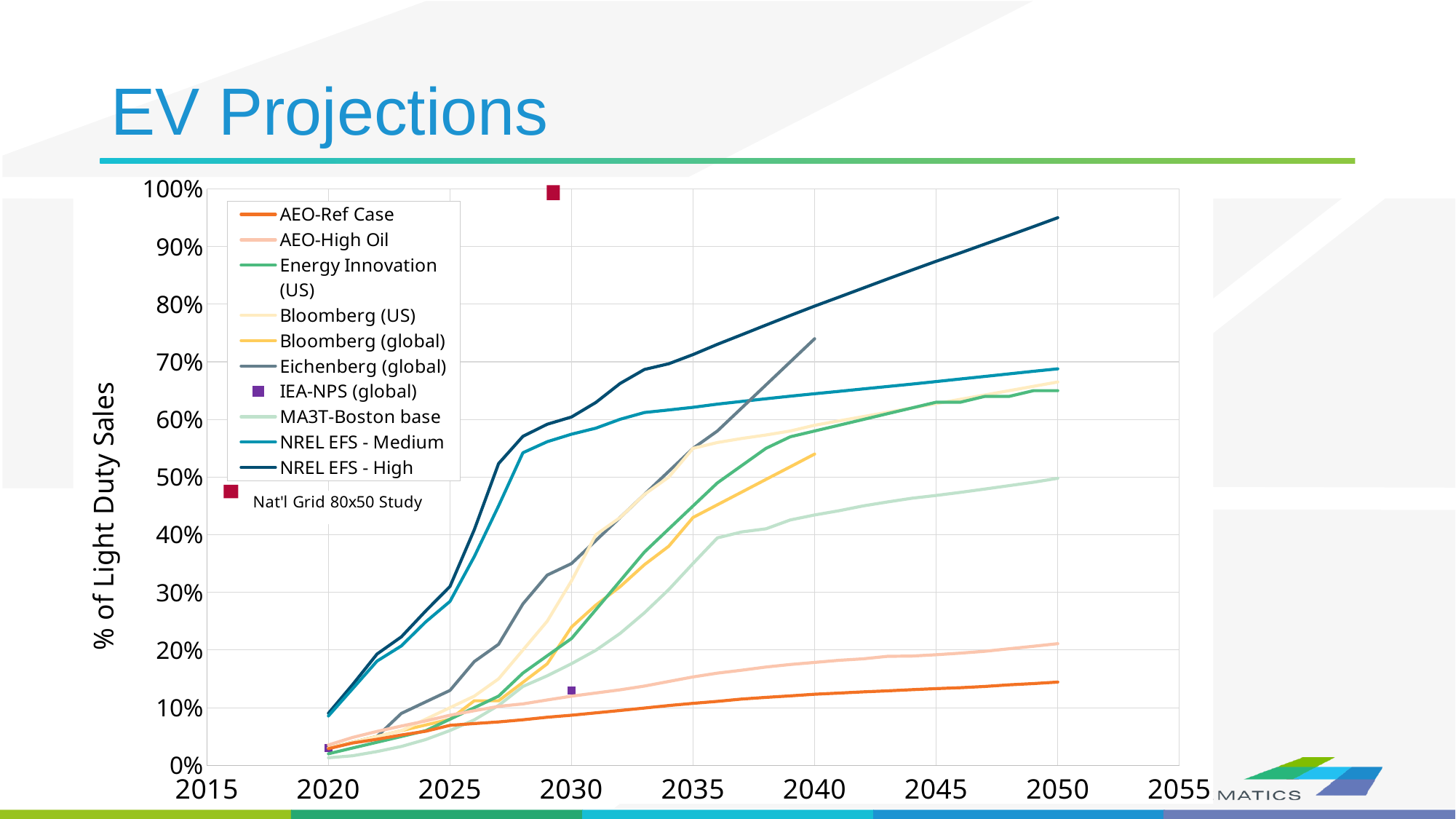
Which series has the lowest value in 2050? AEO-Ref Case What kind of chart is shown on the slide? line chart Is the value for NREL EFS - Medium in 2030 greater or less than 50%? greater Does the AEO-Ref Case series rise or fall from 2020 to 2050? rise Is the IEA-NPS (global) point in 2030 greater or less than 20%? less What is the label on the y axis? % of Light Duty Sales How many series does the legend list? 10 Is the value for Eichenberg (global) in 2040 greater or less than 70%? greater In 2050, which is larger: NREL EFS - Medium or MA3T-Boston base? NREL EFS - Medium Which series has the highest value in 2050? NREL EFS - High